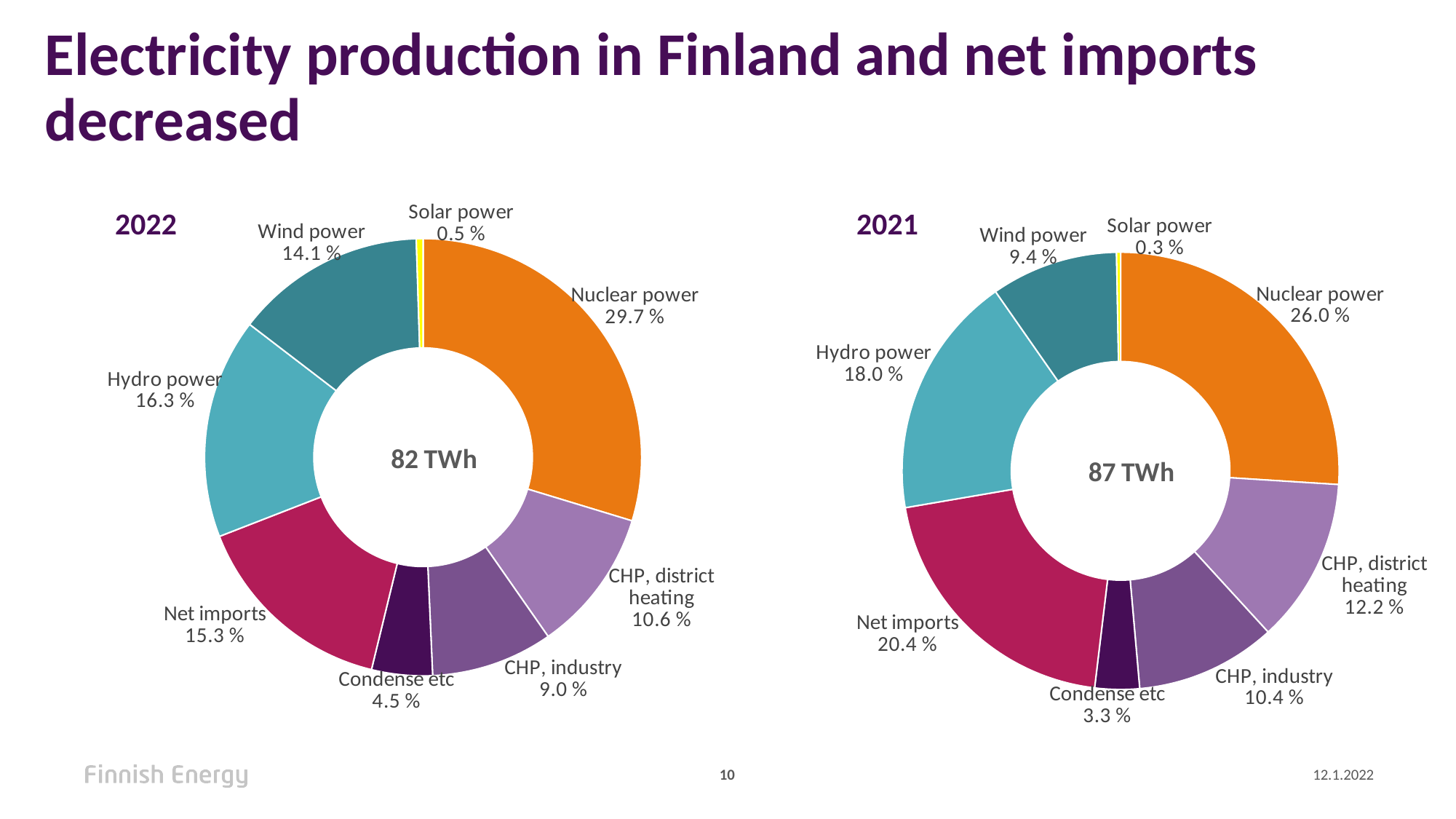
In the 2021 chart, which category has the smallest share? Solar power In the 2021 chart, what share does Wind power have? 9.4 % In the 2022 chart, what share does Nuclear power have? 29.7 % What kind of chart is the 2021 chart? Doughnut (pie) chart In the 2022 chart, which category has the largest share? Nuclear power In the 2021 chart, which is larger: the share of CHP, district heating or the share of CHP, industry? CHP, district heating How many categories does the 2022 chart show? 8 In the 2021 chart, what share does Net imports have? 20.4 % What total is printed in the centre of the 2022 chart? 82 TWh In the 2022 chart, what is the difference between the Hydro power share and the Wind power share? 2.2 % In the 2022 chart, what share does Condense etc have? 4.5 % What total is printed in the centre of the 2021 chart? 87 TWh